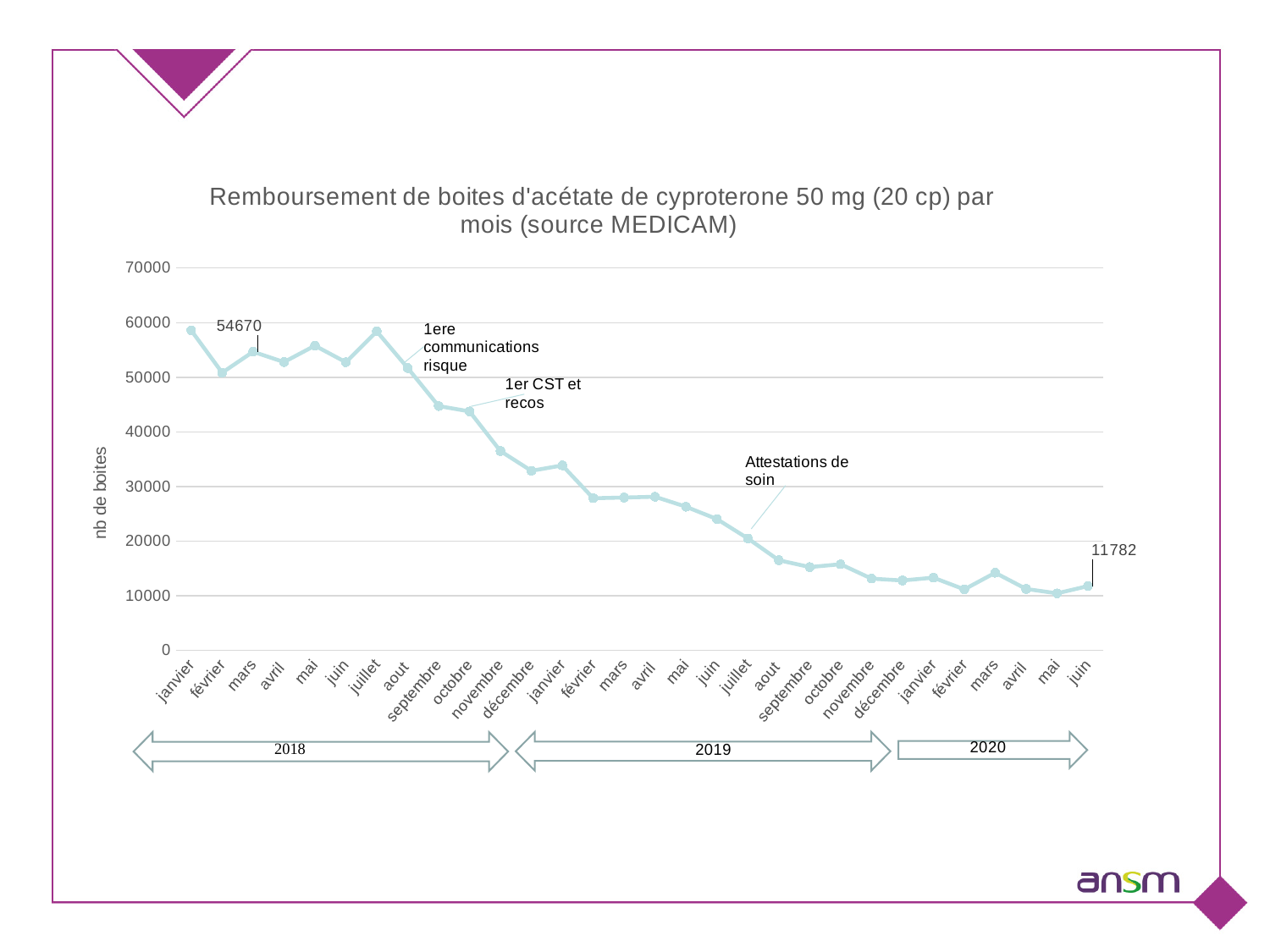
Which is larger, the value for mars 2018 or the value for juin 2020? mars 2018 What is the title of the y axis? nb de boites Is the value for mai 2020 greater or less than 20000? less What is the value for juin 2020? 11782 What is the difference between the value for mars 2018 and the value for juin 2020? 42888 Is the value for décembre 2018 greater or less than 30000? greater Do the values rise or fall along the x axis from janvier 2018 to juin 2020? fall Is the value for janvier 2018 greater or less than 50000? greater What is the value for mars 2018? 54670 What annotation is attached to the point for juillet 2019? Attestations de soin What kind of chart is shown on the slide? line chart How many monthly data points are plotted on the chart? 30